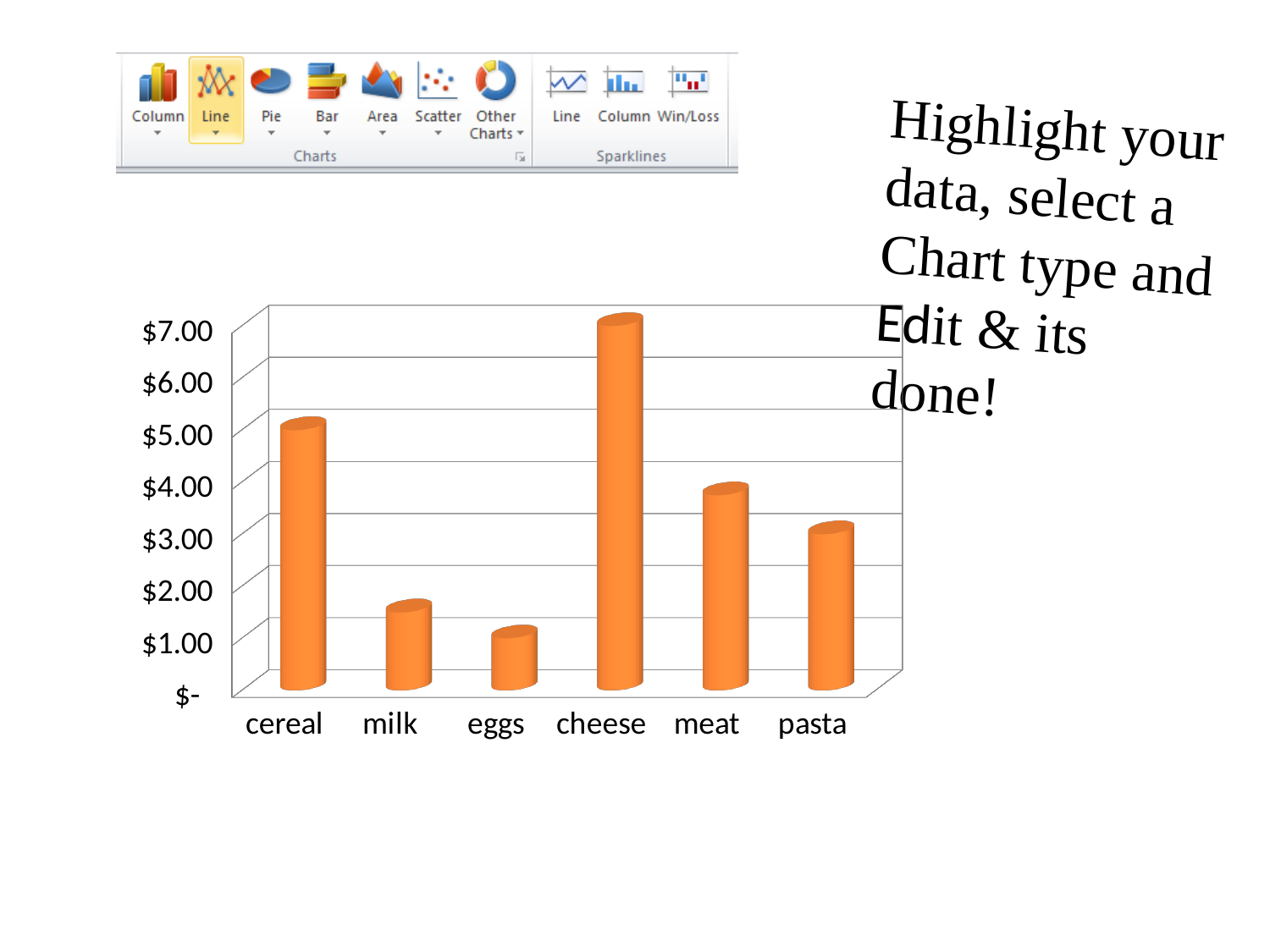
Which category has the lowest bar? eggs Is the value for milk greater or less than $2.00? less Is the value for pasta greater or less than $4.00? less Is the value for cheese greater or less than $6.00? greater What kind of chart is shown on the slide? bar chart Which is larger, the value for milk or the value for eggs? milk Which is larger, the value for cheese or the value for cereal? cheese Which category has the highest bar? cheese Which is larger, the value for meat or the value for pasta? meat How many categories are shown on the x axis? 6